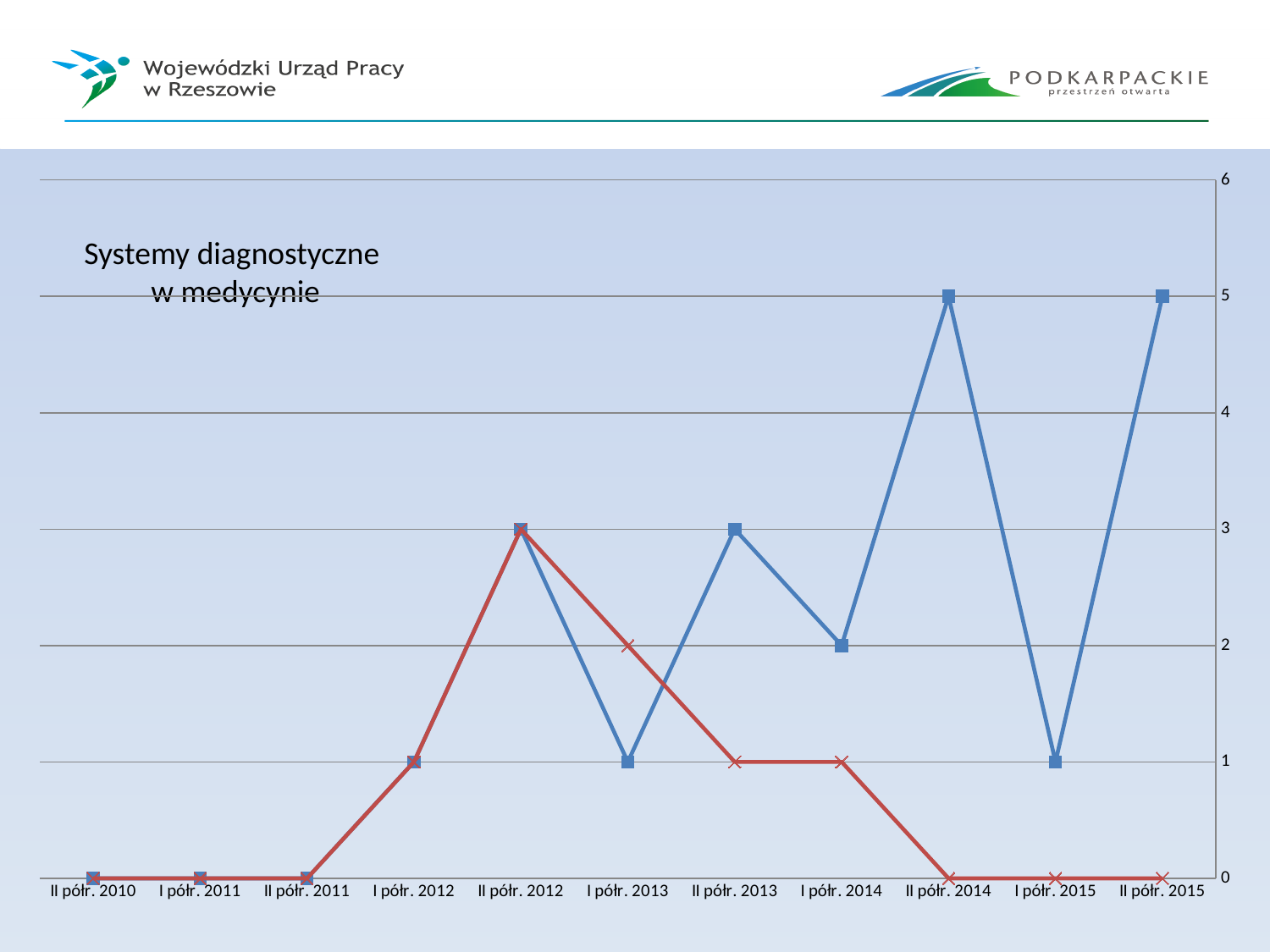
What is the value of the red line at I półr. 2013? 2 At I półr. 2013, which line has the higher value, the blue line or the red line? the red line What is the value of the blue line at II półr. 2014? 5 What is the difference between the blue line and the red line at II półr. 2013? 2 At which category does the red line reach its highest value? II półr. 2012 How many categories are shown on the x axis of the chart? 11 What is the value of the red line at II półr. 2015? 0 How many lines are plotted on the chart? 2 What is the value of the blue line at I półr. 2015? 1 What is the title of the chart? Systemy diagnostyczne w medycynie What kind of chart is shown on the slide? line chart What is the highest value reached by the blue line? 5